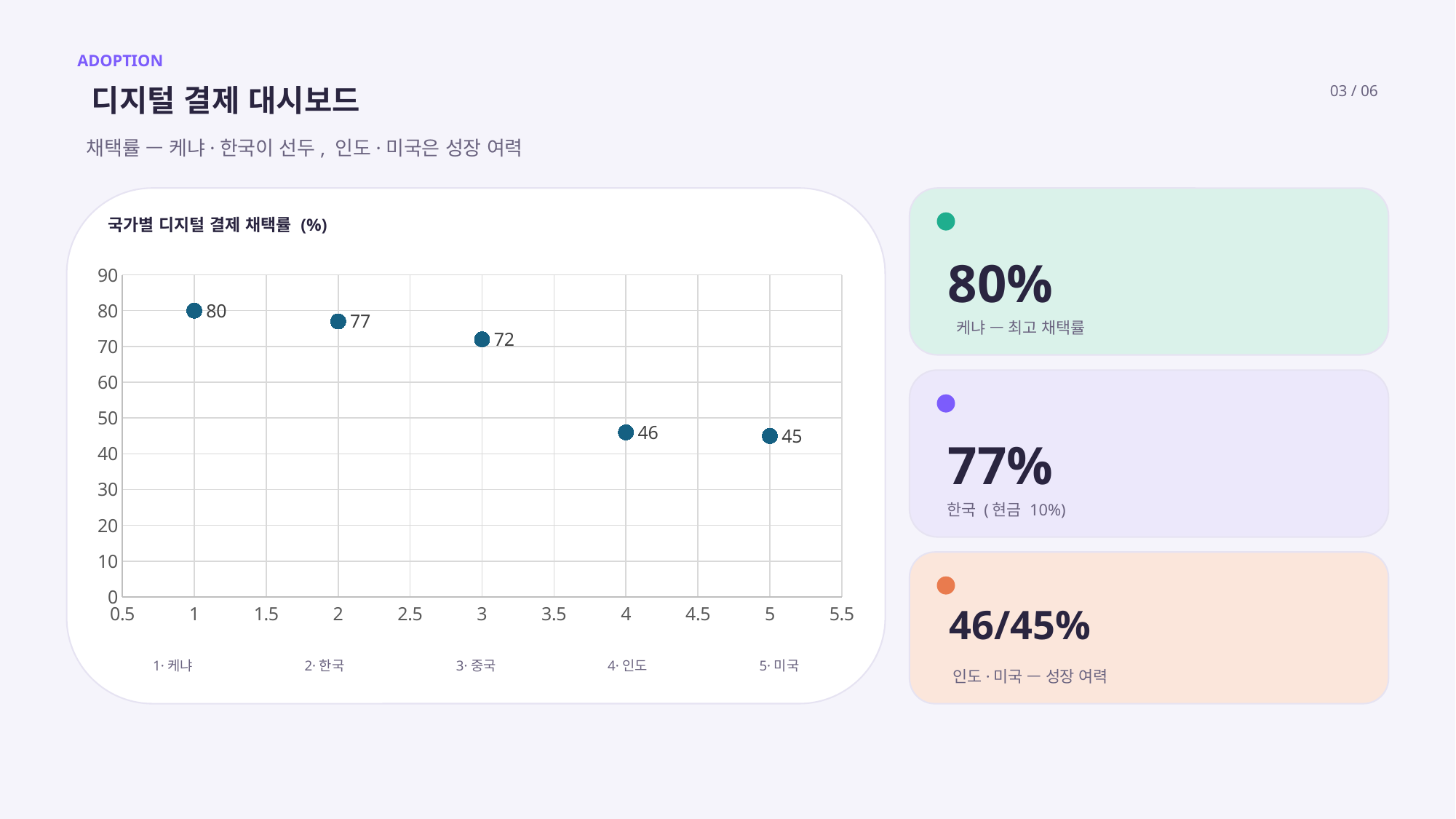
How many data points are plotted on the chart? 5 What is the digital payment adoption rate plotted for 케냐 (point 1)? 80 Do the plotted values rise or fall as you move from point 1 to point 5 along the x axis? fall Which country has the highest plotted adoption rate? 케냐 What value is labelled for 인도 (point 4) on the chart? 46 What value is labelled for 중국 (point 3) on the chart? 72 What is the difference between the values for 케냐 and 미국? 35 What is the difference between the values for 한국 and 중국? 5 What is the title of the chart? 국가별 디지털 결제 채택률 (%) What value is labelled for 한국 (point 2) on the chart? 77 Which is larger, the value for 중국 or the value for 인도? 중국 Which country has the lowest plotted adoption rate? 미국